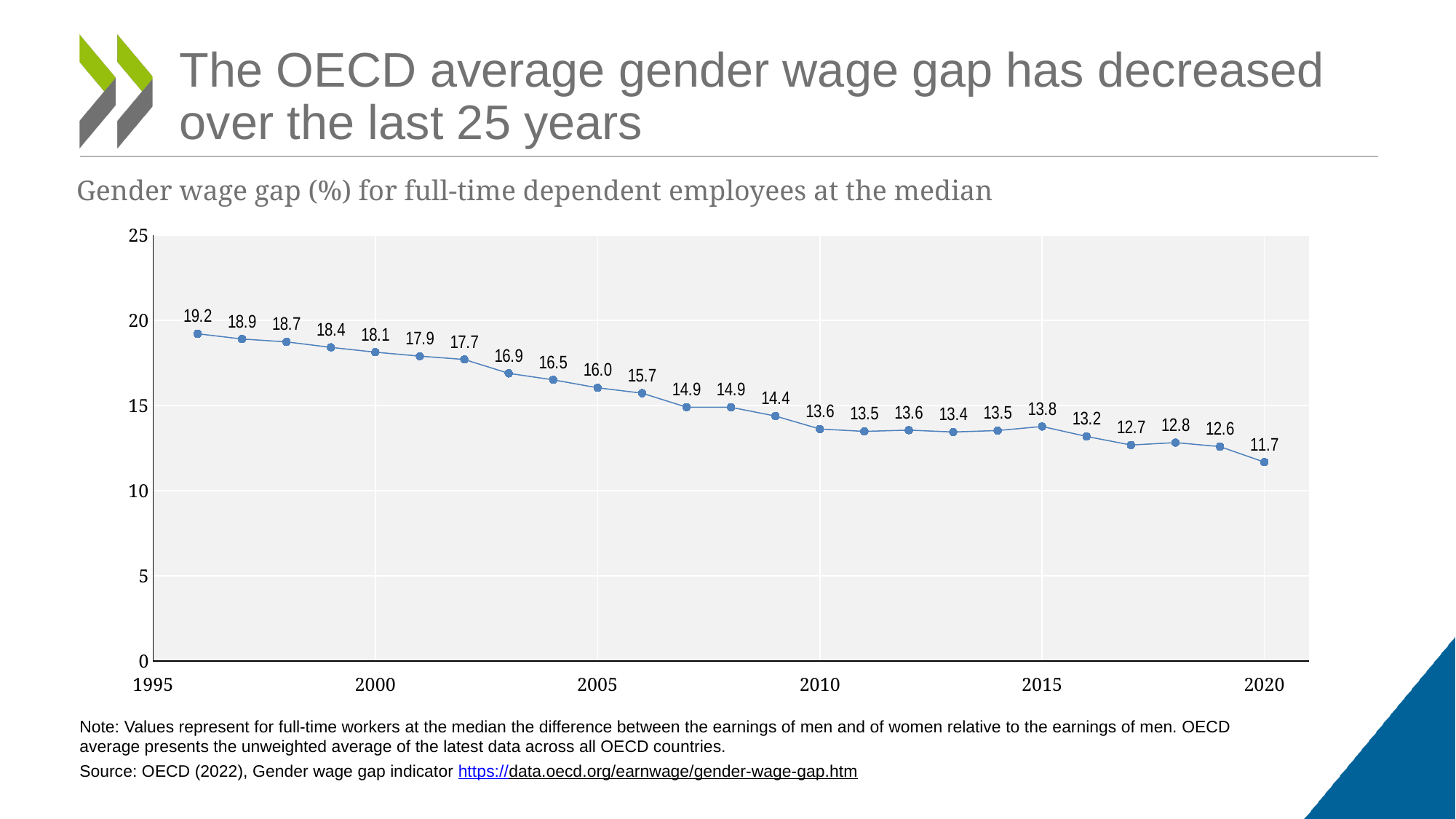
Which year has the larger gender wage gap, 2005 or 2015? 2005 Do the values generally rise or fall from left to right along the x axis? Fall Is the value for 2020 greater or less than 15? less In which year is the gender wage gap lowest? 2020 What type of chart is shown on the slide? Line chart What is the gender wage gap value plotted for 2010? 13.6 What is the highest value plotted on the chart? 19.2 What is the gender wage gap value plotted for 2020? 11.7 What is the difference between the values for 2000 and 2020? 6.4 What is the gender wage gap value plotted for 2015? 13.8 What is the gender wage gap value plotted for 2000? 18.1 How many data points are plotted on the line? 25